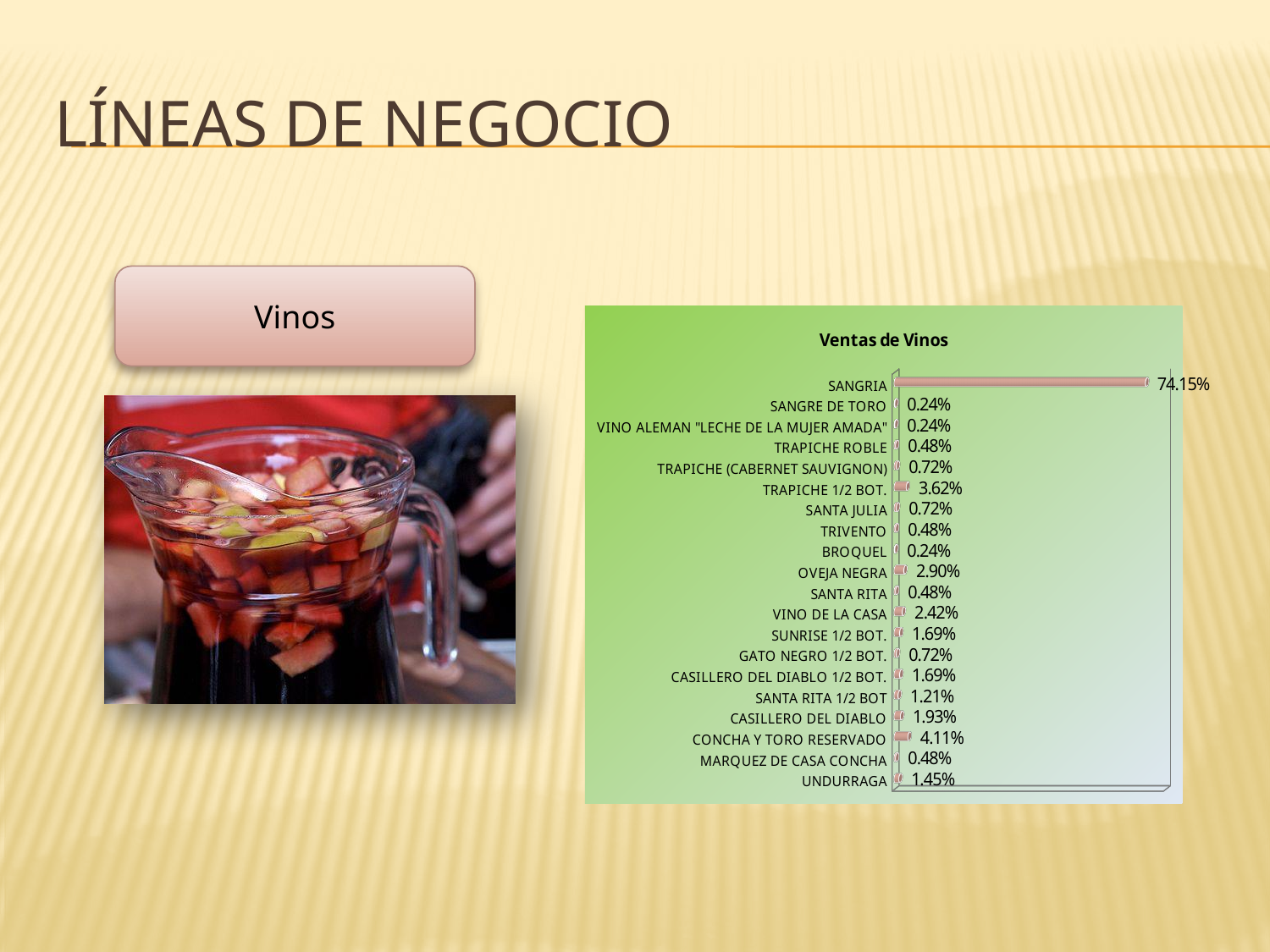
What kind of chart is shown on the slide? Bar chart What is the lowest value shown in the Ventas de Vinos chart? 0.24% What is the difference between the values for SANGRIA and CONCHA Y TORO RESERVADO in the Ventas de Vinos chart? 70.04% What is the difference between the values for TRAPICHE 1/2 BOT. and OVEJA NEGRA in the Ventas de Vinos chart? 0.72% What is the value for CONCHA Y TORO RESERVADO in the Ventas de Vinos chart? 4.11% What is the value for SANGRIA in the Ventas de Vinos chart? 74.15% How many wine categories are plotted in the Ventas de Vinos chart? 20 Which category has the highest value in the Ventas de Vinos chart? SANGRIA What is the value for TRAPICHE 1/2 BOT. in the Ventas de Vinos chart? 3.62% Which is larger in the Ventas de Vinos chart, OVEJA NEGRA or VINO DE LA CASA? OVEJA NEGRA What is the value for UNDURRAGA in the Ventas de Vinos chart? 1.45% What is the title of the chart on the slide? Ventas de Vinos